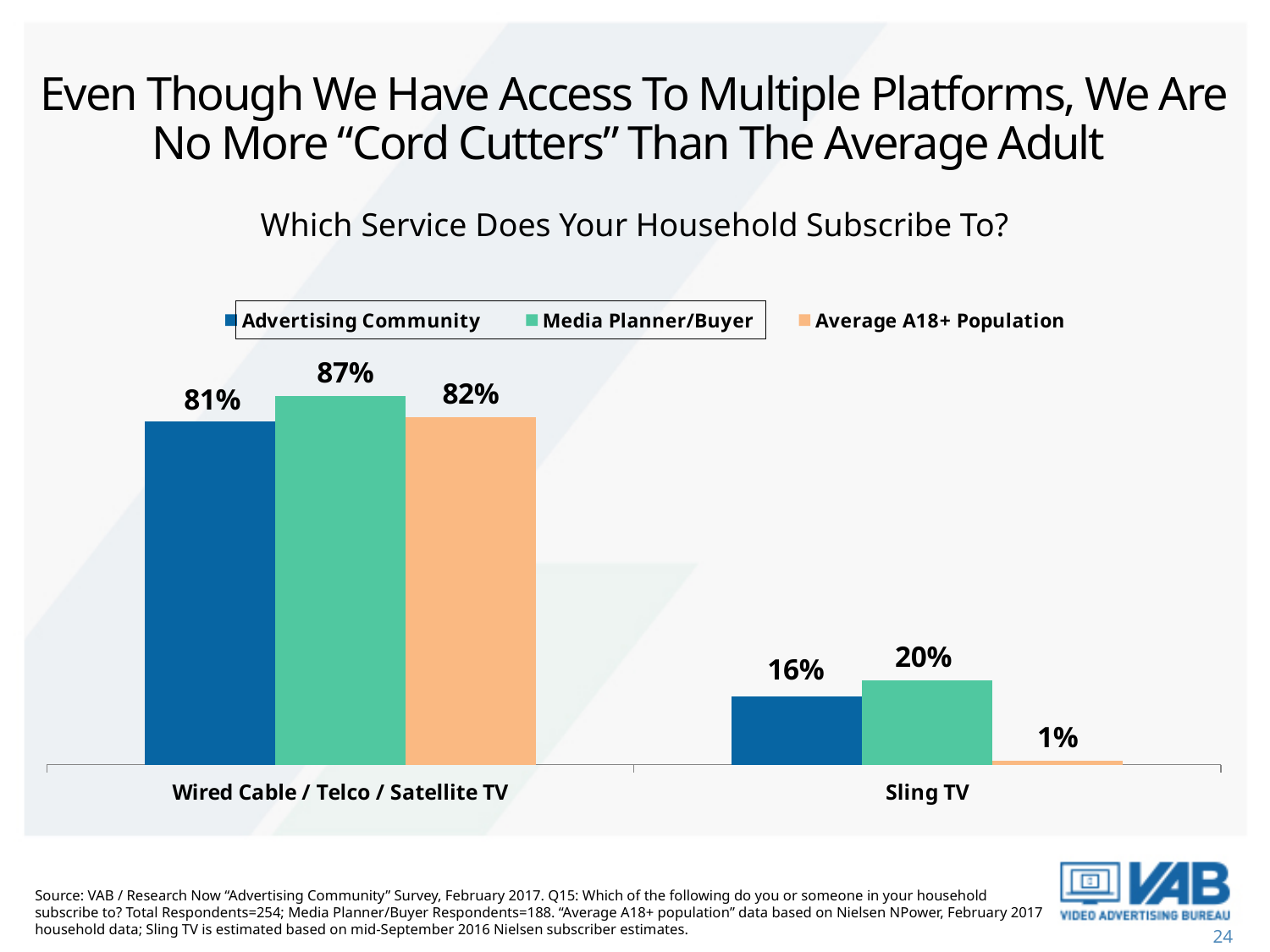
What is the value for the Average A18+ Population for Sling TV? 1% What is the difference between the Media Planner/Buyer and Advertising Community values for Wired Cable / Telco / Satellite TV? 6% Which series has the lowest value for Sling TV? Average A18+ Population What is the difference between the Media Planner/Buyer and Advertising Community values for Sling TV? 4% What is the value for the Average A18+ Population for Wired Cable / Telco / Satellite TV? 82% How many categories are shown on the x axis? 2 What percentage of the Advertising Community subscribes to Wired Cable / Telco / Satellite TV? 81% Which series has the highest value for Wired Cable / Telco / Satellite TV? Media Planner/Buyer What is the value for Media Planner/Buyer for Sling TV? 20% What kind of chart is shown on the slide? Bar chart For Sling TV, which is larger: the Advertising Community value or the Media Planner/Buyer value? Media Planner/Buyer How many series does the legend list? 3